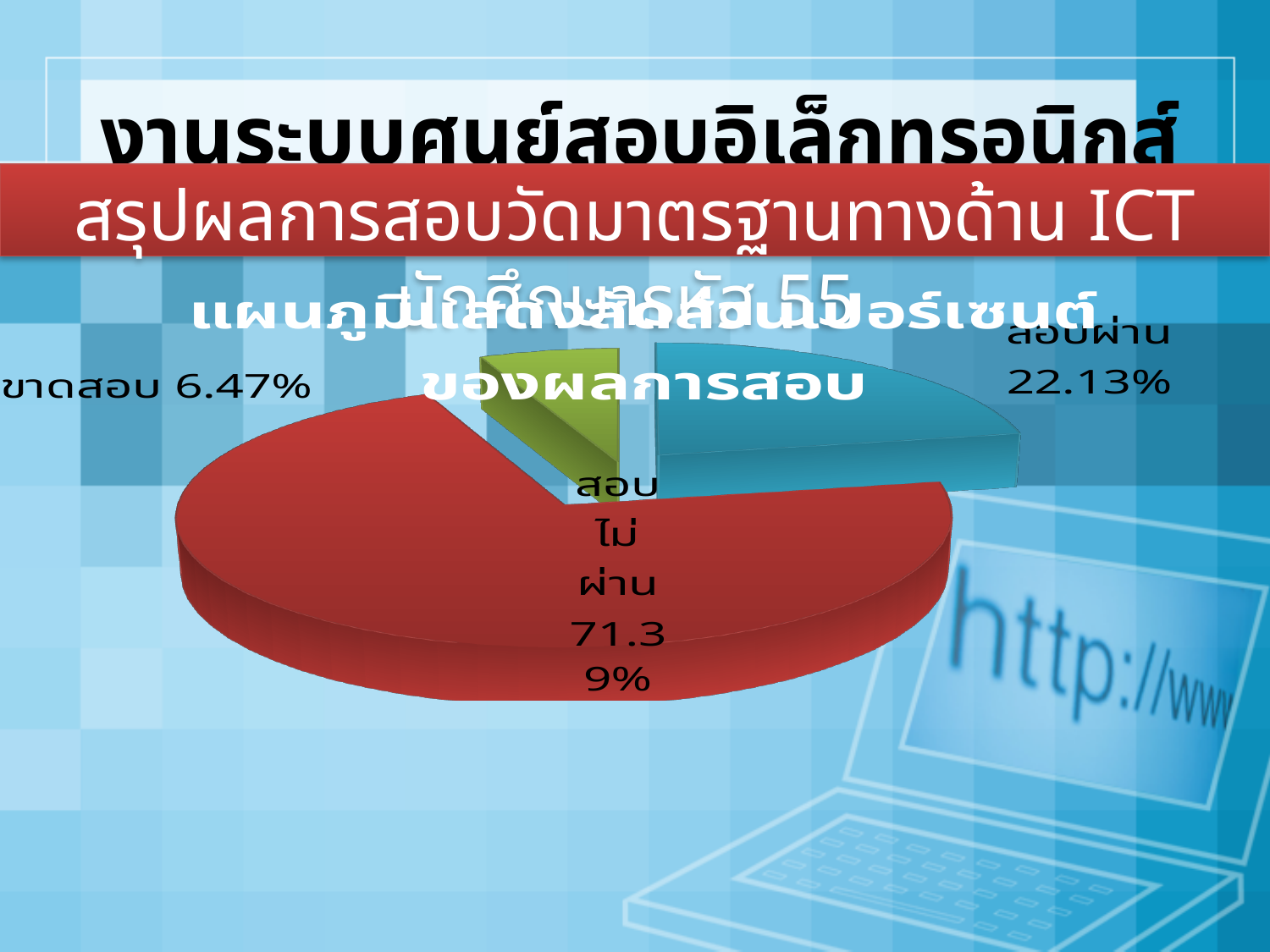
What percentage of the pie chart is labelled ขาดสอบ? 6.47% Which category has the largest share of the pie chart? สอบไม่ผ่าน What is the difference in percentage points between สอบไม่ผ่าน and สอบผ่าน? 49.26 Which is larger, the share for สอบผ่าน or the share for ขาดสอบ? สอบผ่าน What colour is the slice for สอบไม่ผ่าน? red What percentage of the pie chart is labelled สอบไม่ผ่าน? 71.39% What percentage of the pie chart is labelled สอบผ่าน? 22.13% What colour is the slice for สอบผ่าน? blue How many slices does the pie chart have? 3 What is the difference in percentage points between สอบผ่าน and ขาดสอบ? 15.66 What kind of chart is shown on the slide? pie chart Which category has the smallest share of the pie chart? ขาดสอบ